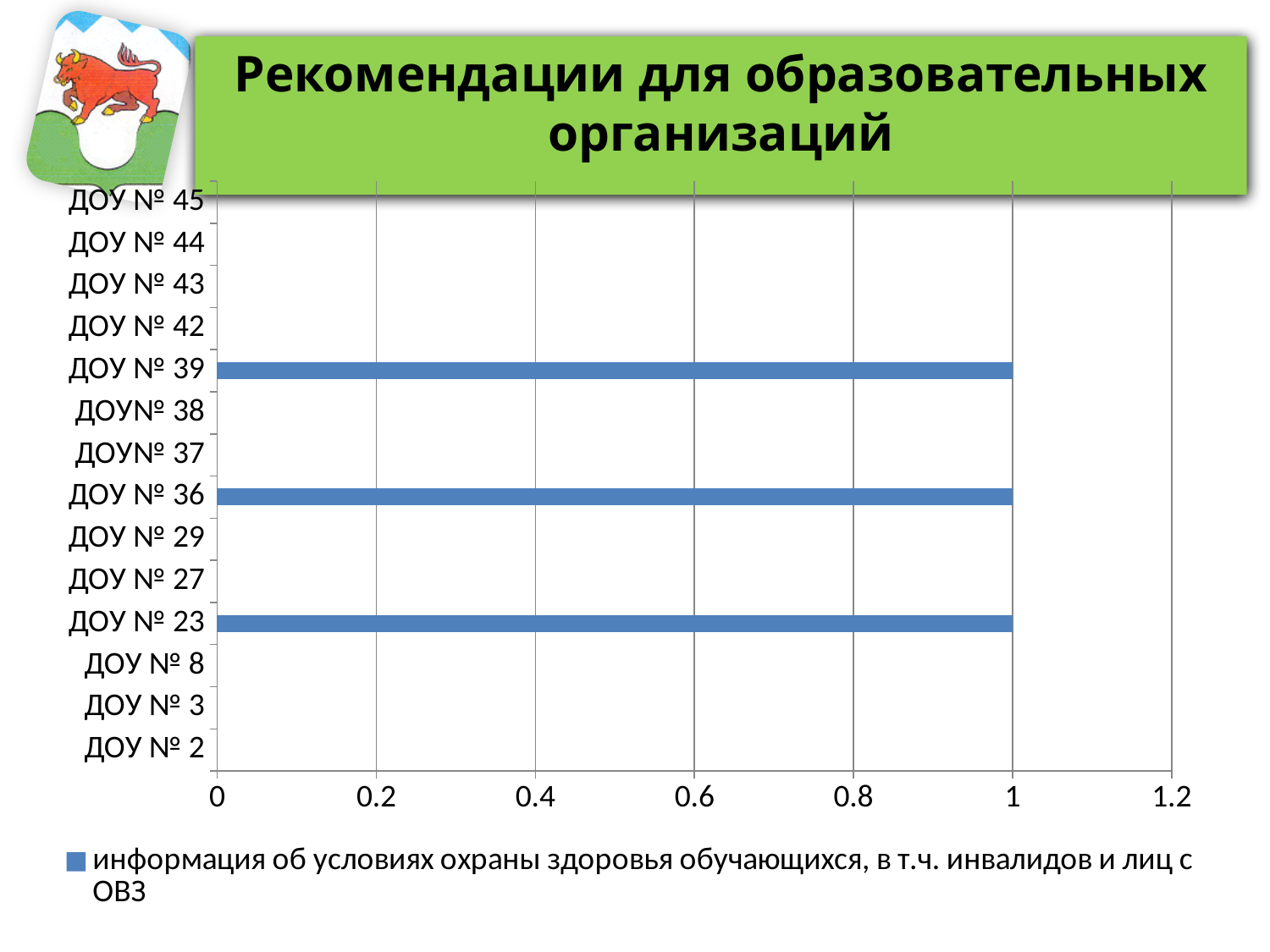
What is the value for ДОУ № 23? 1 What is the value for ДОУ № 39? 1 What kind of chart is shown on the slide? bar chart What is the highest value shown on the horizontal axis of the chart? 1.2 Is the value for ДОУ № 39 greater or less than 1.2? less What is the value for ДОУ № 36? 1 What is the title of the slide containing the chart? Рекомендации для образовательных организаций How many categories in the chart have a visible bar? 3 How many series does the chart legend list? 1 Which has the larger value, ДОУ № 39 or ДОУ № 44? ДОУ № 39 How many categories (ДОУ) are listed on the vertical axis of the chart? 14 Is the value for ДОУ № 36 greater or less than 0.8? greater